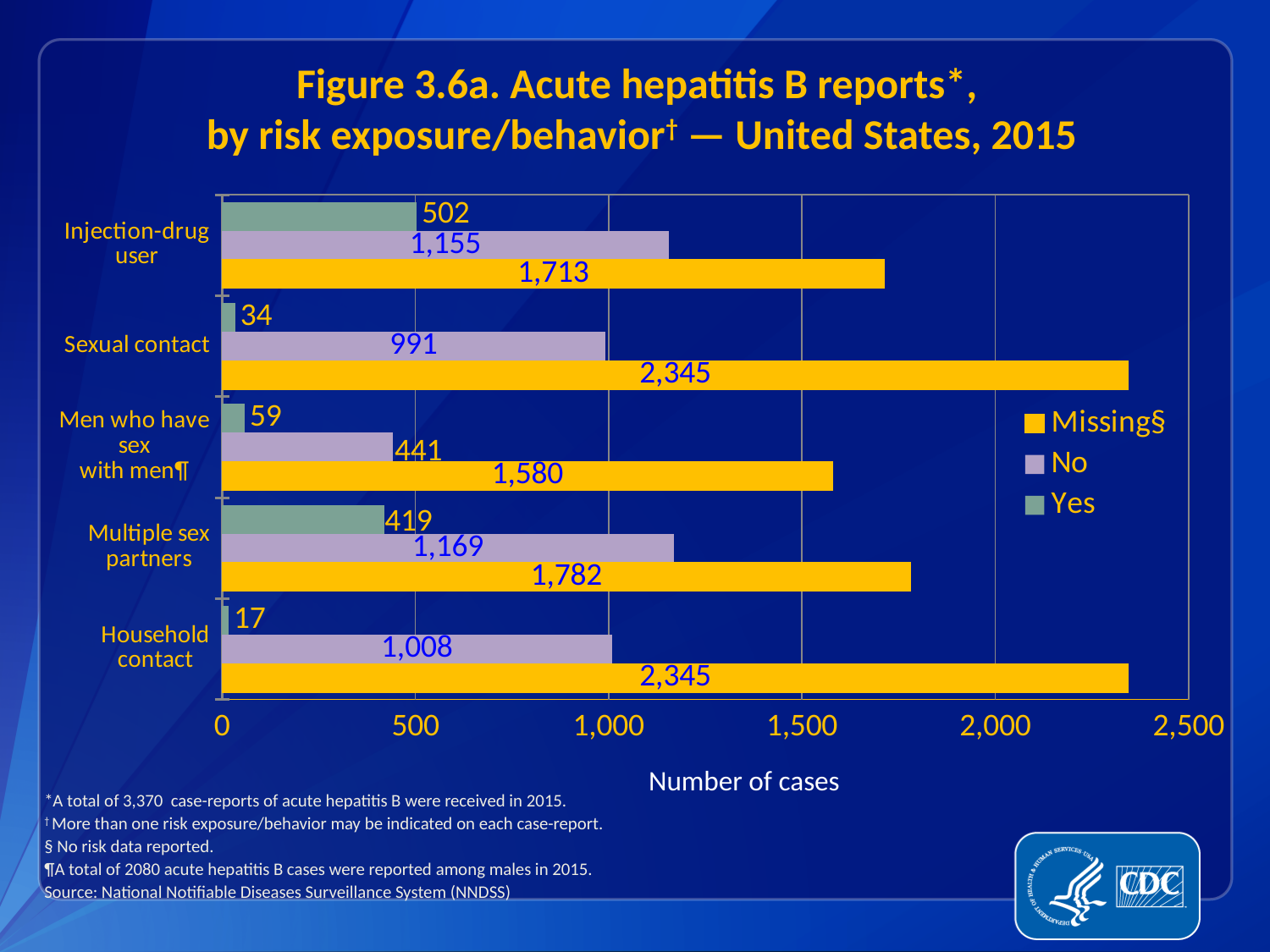
Is the 'No' value for household contact greater or less than 1,000? greater What is the 'Missing' value for men who have sex with men? 1,580 Which is larger, the 'Missing' value for injection-drug user or the 'Missing' value for multiple sex partners? Multiple sex partners What is the difference between the 'No' and 'Yes' values for multiple sex partners? 750 Which category has the lowest 'Yes' value? Household contact Which category has the highest 'Yes' value? Injection-drug user What is the number of cases for 'No' for sexual contact? 991 What type of chart is shown on the slide? Bar chart How many risk exposure/behavior categories are shown on the chart? 5 What is the number of cases for 'Yes' among injection-drug users? 502 What is the label of the x axis? Number of cases How many series does the legend list? 3